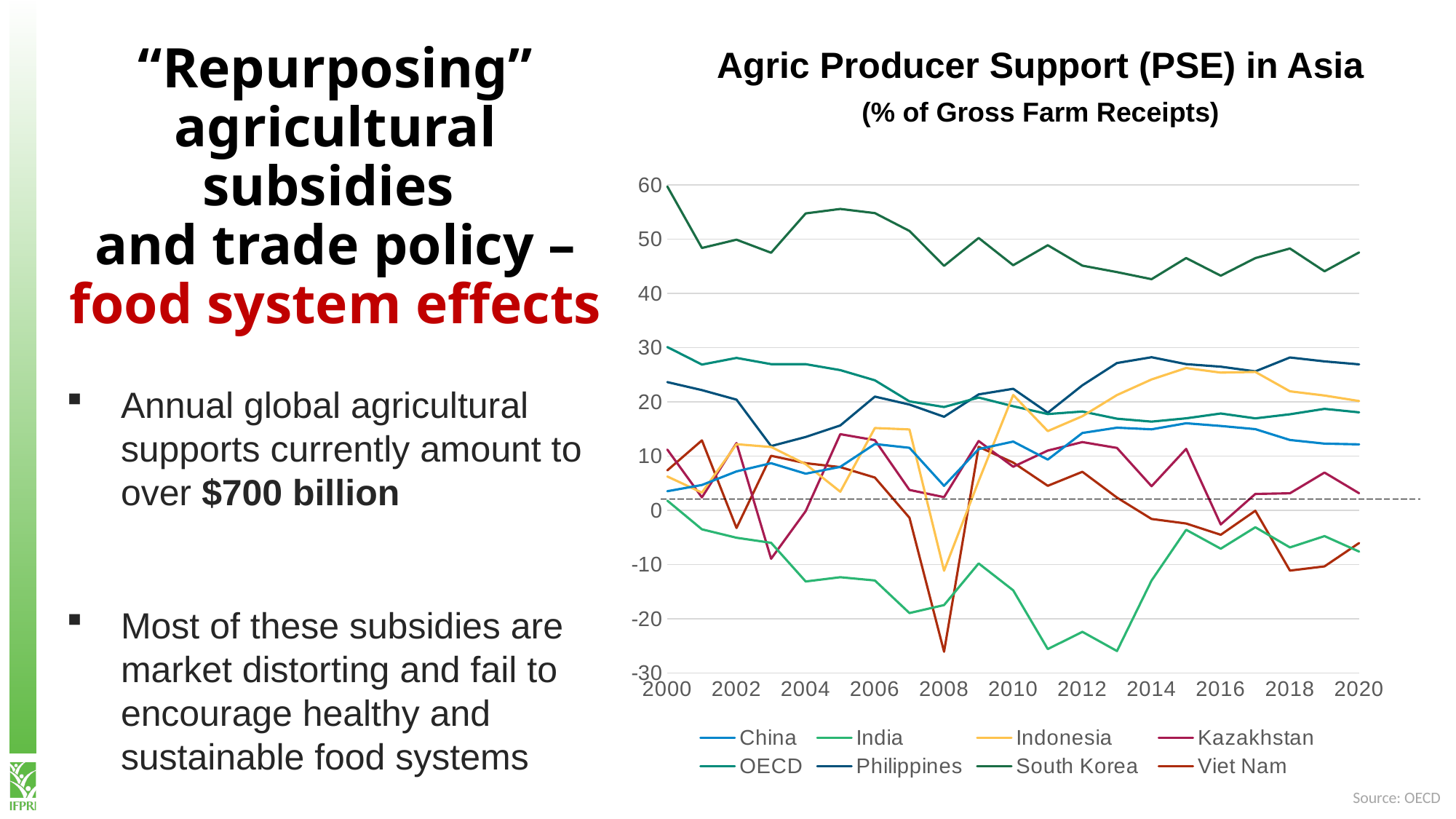
Is the value for Viet Nam in 2008 greater or less than -20? less Does the value for Indonesia rise or fall overall from 2000 to 2020? rise How many series does the legend of the chart list? 8 What unit does the chart subtitle say the values are expressed in? % of Gross Farm Receipts Which series has the lowest value in 2013? India What kind of chart is shown on the slide? line chart Is the value for OECD in 2000 greater or less than 20? greater Is the value for India in 2011 greater or less than -20? less Which series has the highest values across the whole period in the chart? South Korea In 2016, which is higher: Indonesia or Kazakhstan? Indonesia In 2020, which is higher: China or Philippines? Philippines